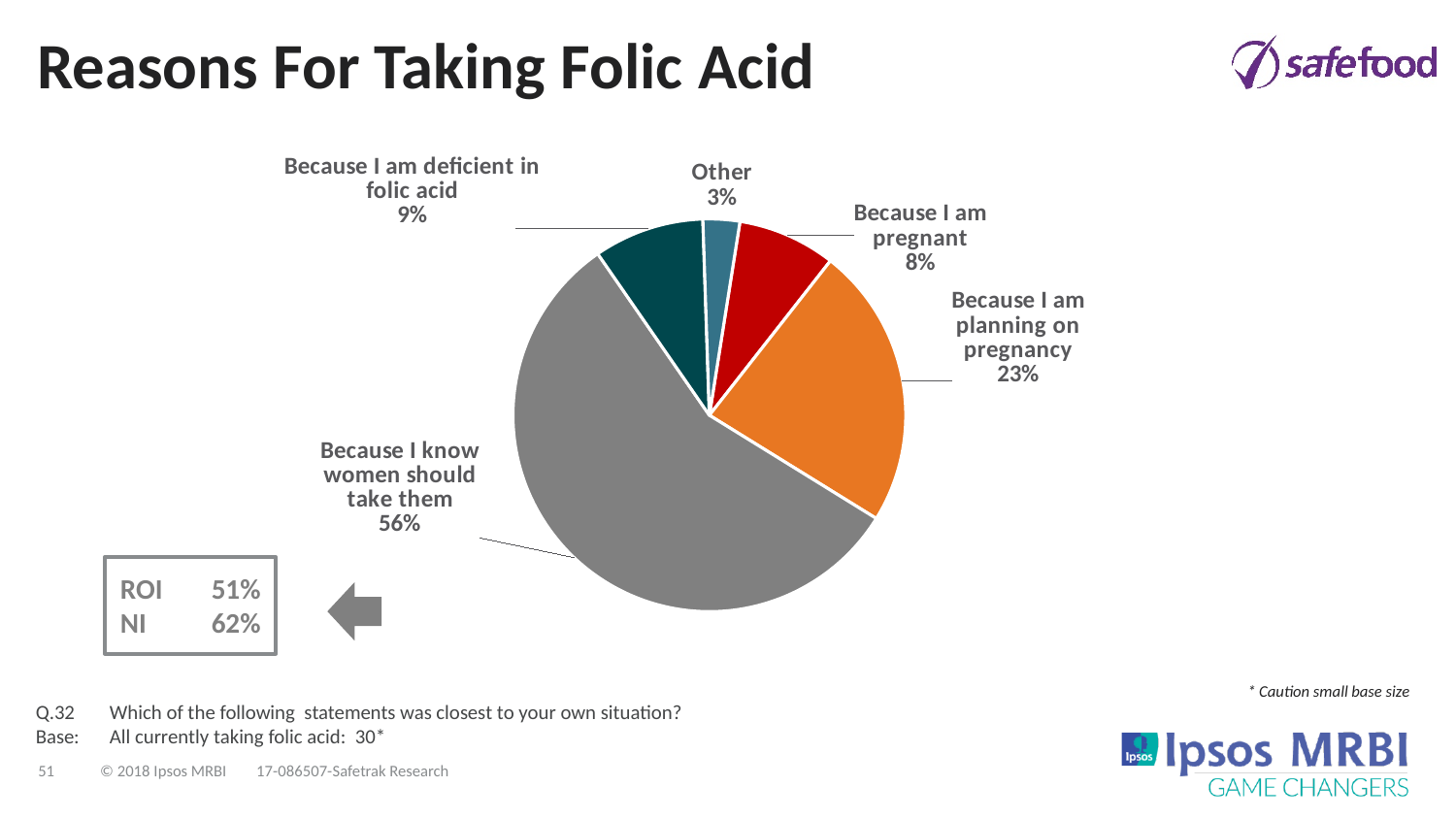
Which is larger: the share for 'Because I am deficient in folic acid' or 'Because I am pregnant'? Because I am deficient in folic acid Which reason has the largest share of the pie? Because I know women should take them What percentage of respondents take folic acid because they are deficient in folic acid? 9% What percentage of respondents take folic acid because they are planning on pregnancy? 23% What percentage of respondents take folic acid because they know women should take them? 56% What kind of chart is shown on the slide? pie chart How many slices does the pie chart have? 5 Which reason has the smallest share of the pie? Other What is the title of the chart? Reasons For Taking Folic Acid What is the difference in percentage points between 'Because I know women should take them' and 'Because I am planning on pregnancy'? 33 What percentage of respondents take folic acid because they are pregnant? 8% What percentage of respondents gave 'Other' as their reason? 3%